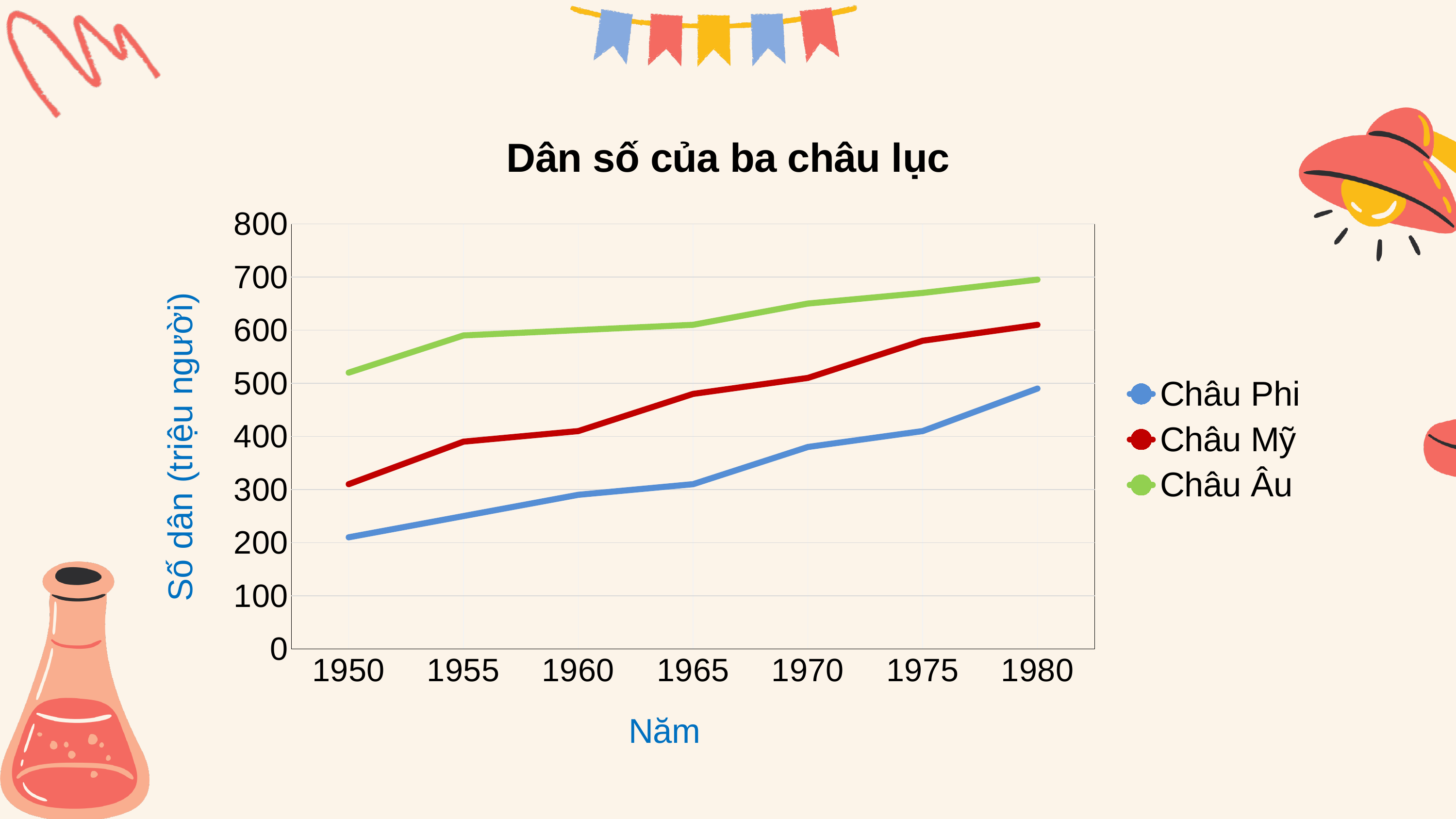
Is the value for Châu Âu in 1980 greater or less than 600? greater In 1960, which is larger: the value for Châu Âu or the value for Châu Phi? Châu Âu Is the value for Châu Mỹ in 1980 greater or less than 500? greater Which series has the highest value in 1980? Châu Âu Which series has the lowest value in 1950? Châu Phi What kind of chart is shown on the slide? line chart What is the label of the vertical axis? Số dân (triệu người) How many years are shown on the x axis? 7 Does the Châu Phi line rise or fall from 1950 to 1980? rise What is the title of the chart? Dân số của ba châu lục Is the value for Châu Phi in 1950 greater or less than 300? less How many series does the legend list? 3